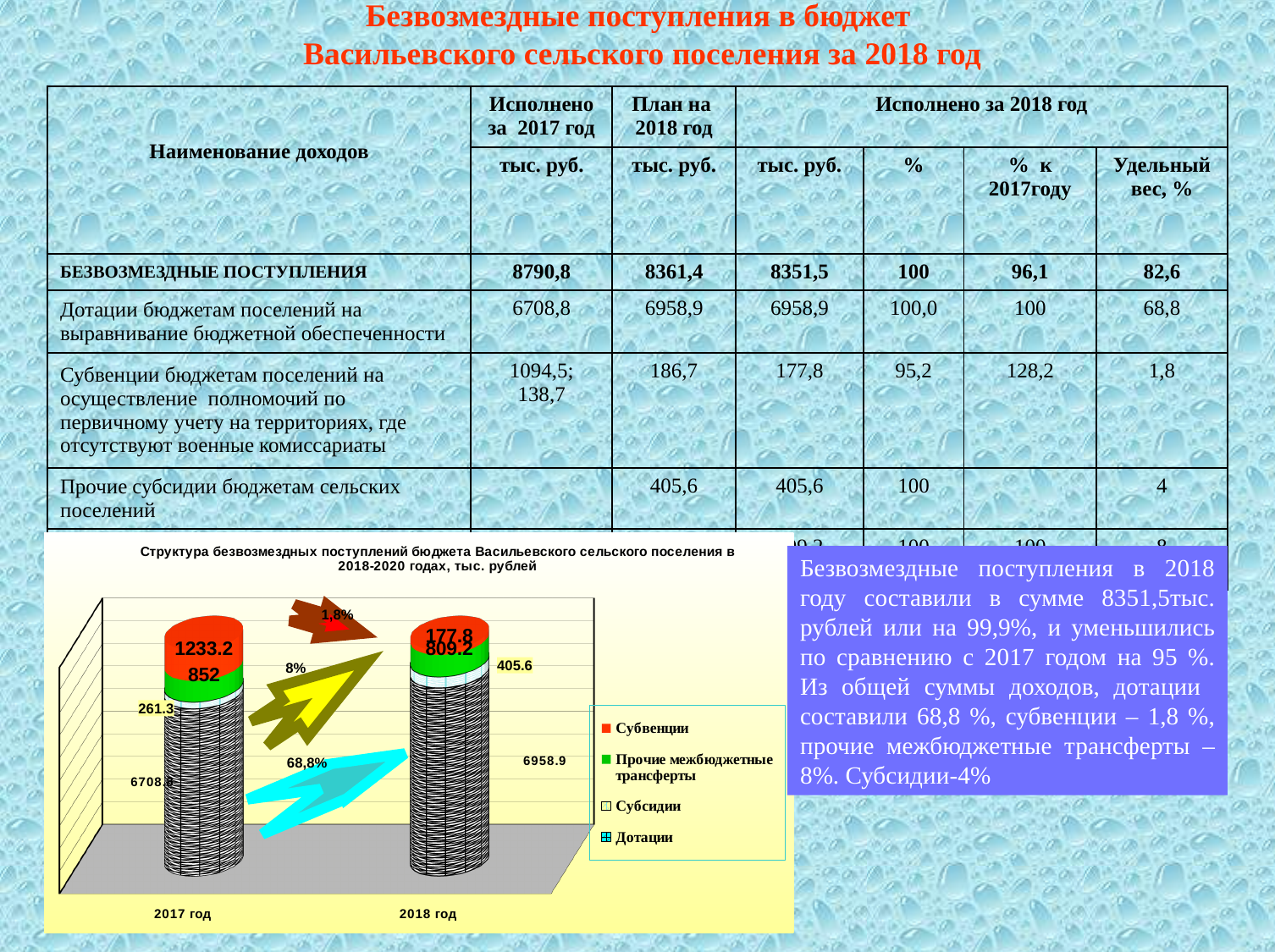
By how much does the value of Субсидии in 2018 год exceed that in 2017 год? 144.3 What is the total of the stacked bar for 2018 год? 8351.5 Which colour represents Субвенции in the chart legend? Red How many categories (years) are shown on the x axis of the chart? 2 What is the value of Прочие межбюджетные трансферты for 2017 год in the chart? 852 What kind of chart is shown on the slide? Stacked bar chart What is the value of Субвенции for 2018 год in the chart? 177.8 How many series does the chart legend list? 4 What is the value of Дотации for 2018 год in the chart? 6958.9 What is the value of Субвенции for 2017 год in the chart? 1233.2 Which year has the larger value for Субвенции, 2017 год or 2018 год? 2017 год What is the value of Субсидии for 2018 год in the chart? 405.6